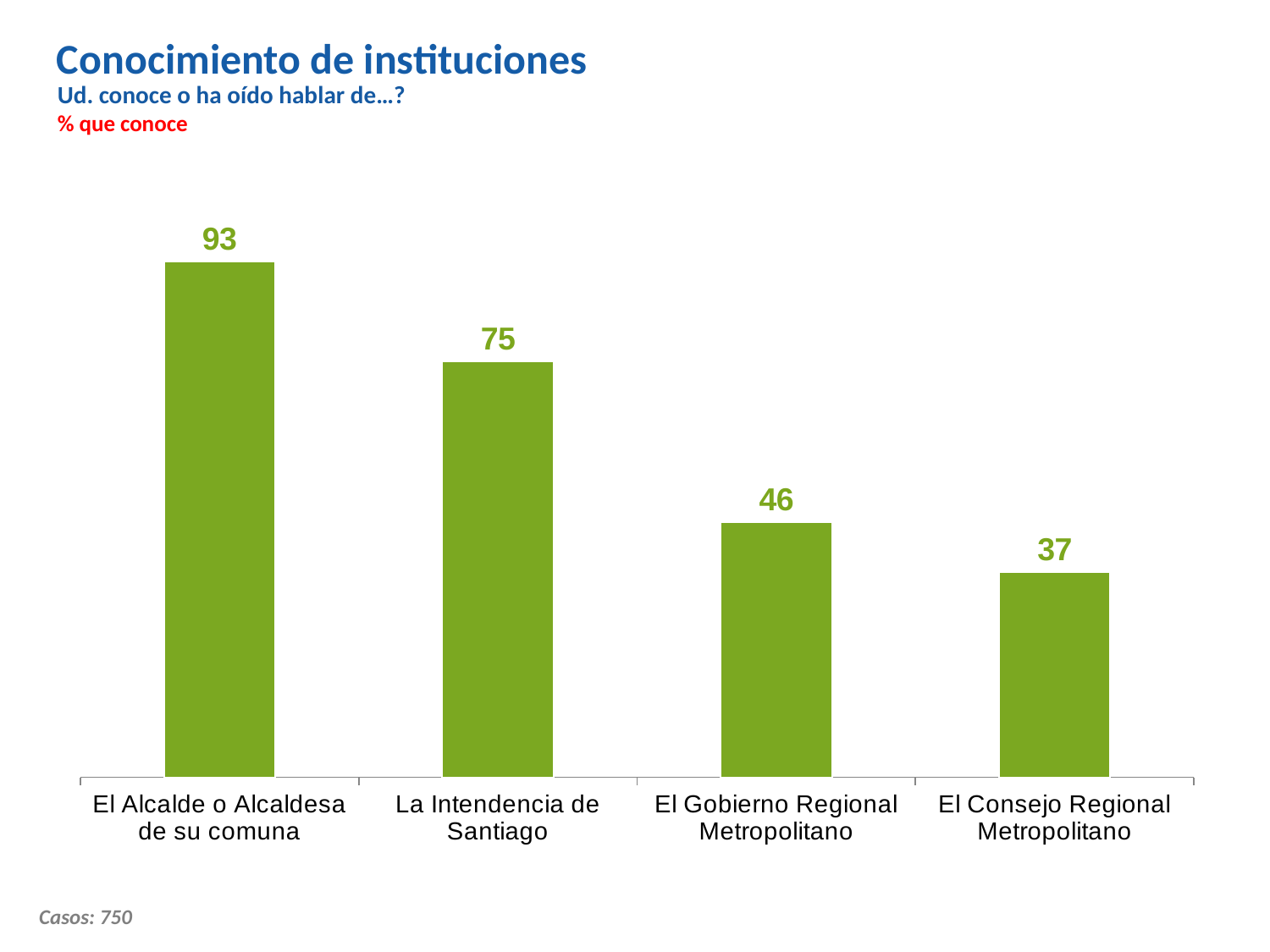
Which category has the highest value? El Alcalde o Alcaldesa de su comuna How many categories are shown in the chart? 4 What is the value for El Gobierno Regional Metropolitano? 46 Which category has the lowest value? El Consejo Regional Metropolitano What is the difference between the values for El Alcalde o Alcaldesa de su comuna and La Intendencia de Santiago? 18 What is the value for La Intendencia de Santiago? 75 What is the value for El Consejo Regional Metropolitano? 37 What is the difference between the values for El Gobierno Regional Metropolitano and El Consejo Regional Metropolitano? 9 What kind of chart is shown on the slide? Bar chart Do the values rise or fall from left to right along the x axis? Fall Which is larger, the value for La Intendencia de Santiago or the value for El Gobierno Regional Metropolitano? La Intendencia de Santiago What is the value for El Alcalde o Alcaldesa de su comuna? 93